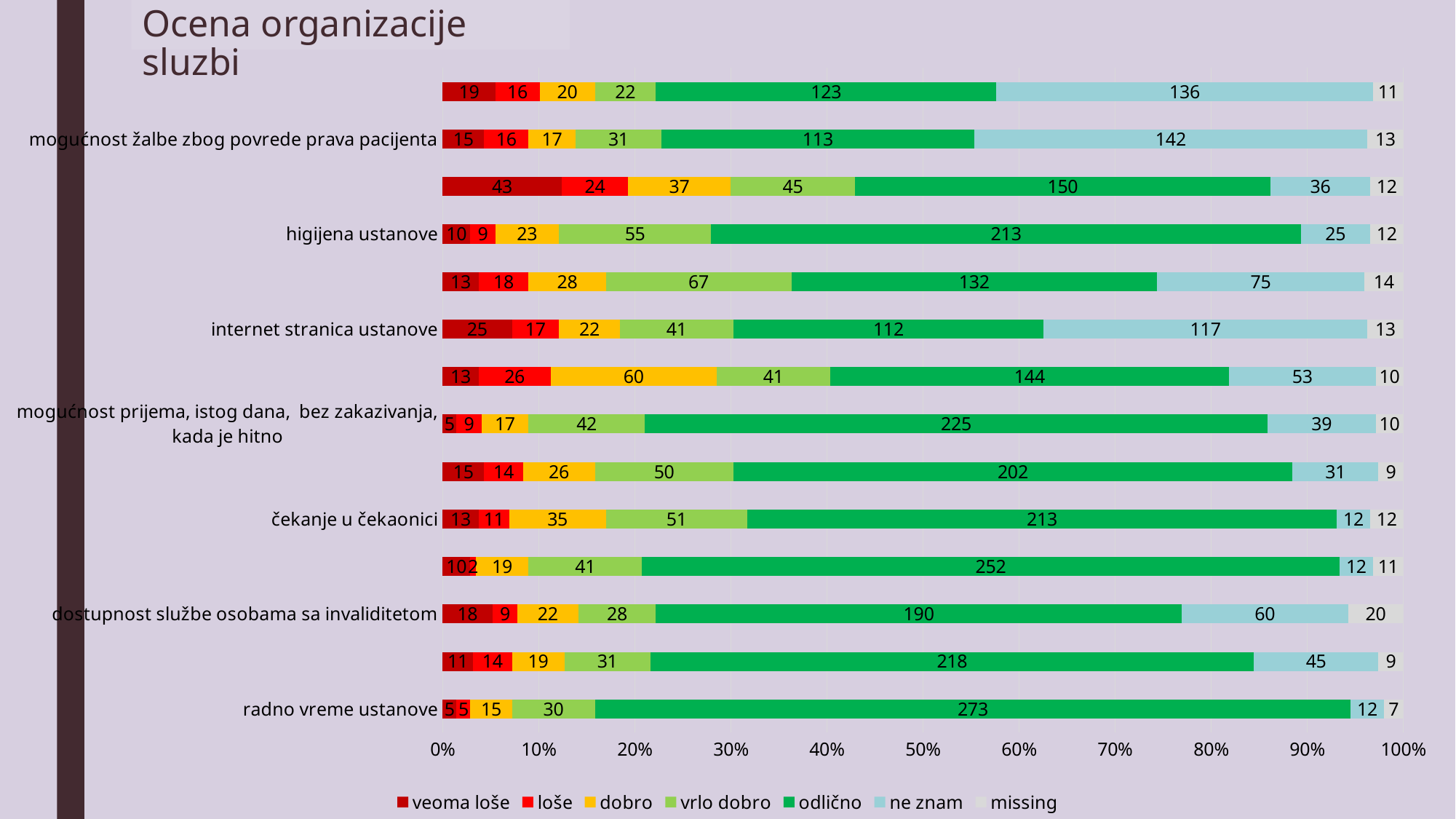
What is the 'missing' value for 'dostupnost službe osobama sa invaliditetom'? 20 What is the difference between the 'odlično' values for 'radno vreme ustanove' and 'čekanje u čekaonici'? 60 Which legend entry is shown in light blue? ne znam What is the 'veoma loše' value for 'internet stranica ustanove'? 25 What type of chart is shown on the slide? stacked bar chart What is the total of all segments in the 'radno vreme ustanove' bar? 347 How many series does the legend list? 7 What is the 'ne znam' value for 'mogućnost žalbe zbog povrede prava pacijenta'? 142 Which is larger for 'internet stranica ustanove': the 'odlično' value or the 'ne znam' value? ne znam What is the title of the chart? Ocena organizacije sluzbi What is the 'vrlo dobro' value for 'higijena ustanove'? 55 What is the 'odlično' value for 'radno vreme ustanove'? 273